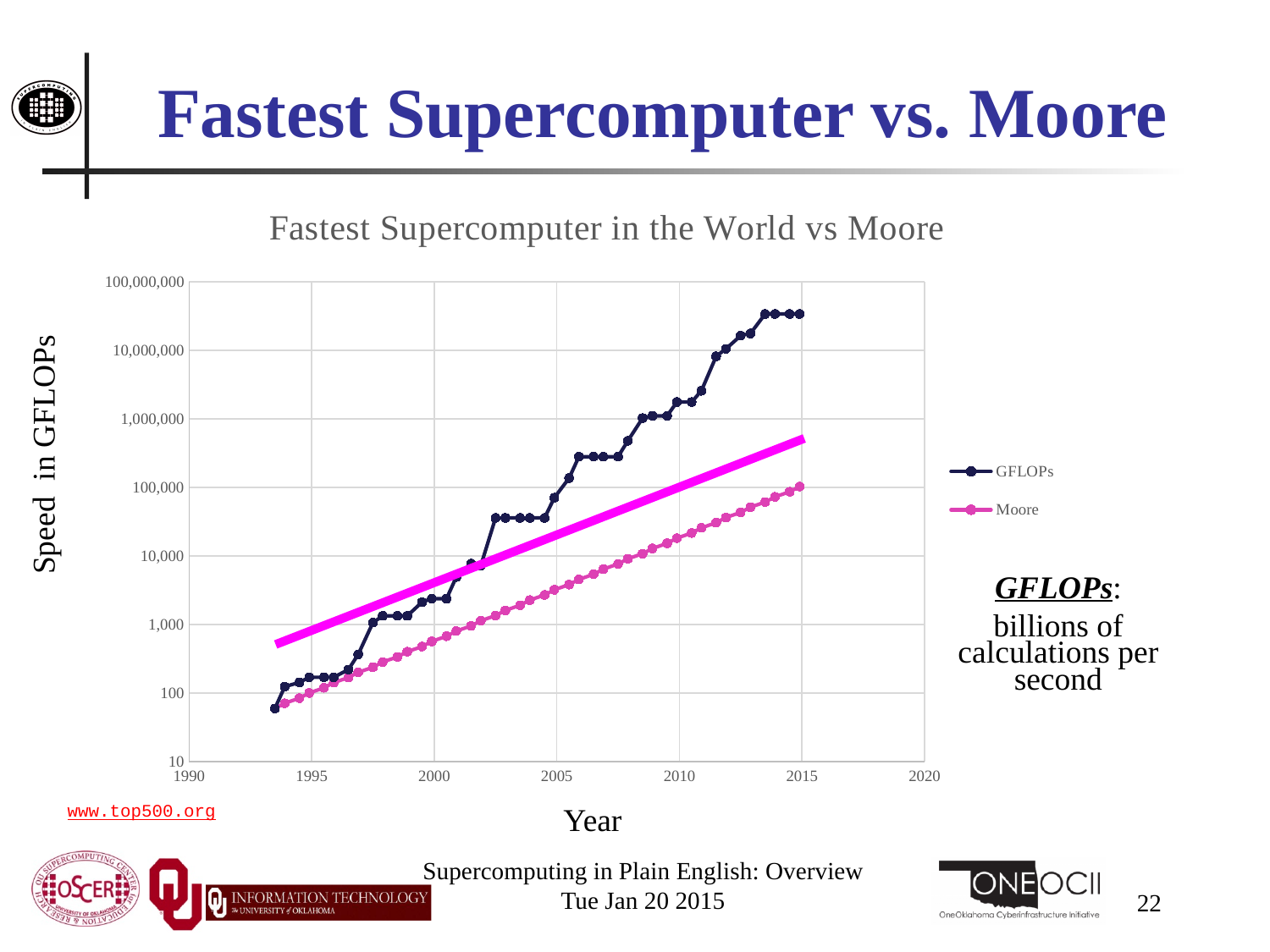
What are the two series named in the legend? GFLOPs and Moore What kind of chart is shown on the slide? line chart Is the Moore value in 2015 greater or less than 1,000,000? less Is the GFLOPs value in 2015 greater or less than 10,000,000? greater Is the GFLOPs value in 2000 greater or less than 10,000? less Does the GFLOPs series rise or fall as the year increases? rise What is the title of the chart? Fastest Supercomputer in the World vs Moore In 2015, which series has the larger value, GFLOPs or Moore? GFLOPs Does the Moore series rise or fall as the year increases? rise How many series does the legend list? 2